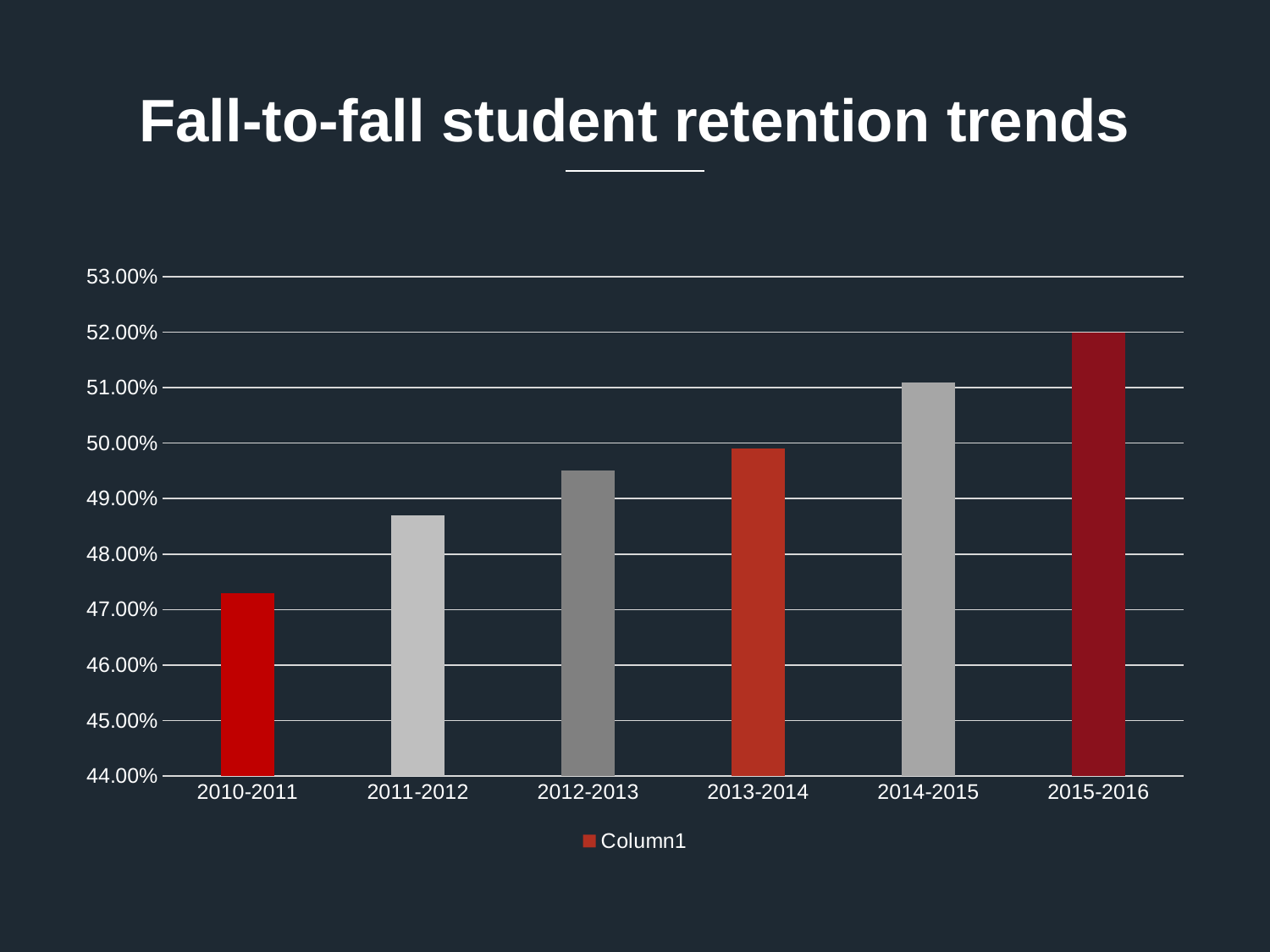
Which academic year has the highest retention rate? 2015-2016 What is the name of the series shown in the legend? Column1 How many academic years are shown on the x axis? 6 Do the retention rates rise or fall from 2010-2011 to 2015-2016? rise What kind of chart is shown on the slide? bar chart Is the value for 2011-2012 greater or less than 48.00%? greater Which is larger, the value for 2014-2015 or the value for 2012-2013? 2014-2015 How many series does the legend list? 1 Is the value for 2012-2013 greater or less than 50.00%? less Is the value for 2010-2011 greater or less than 48.00%? less What is the title of the chart? Fall-to-fall student retention trends Which academic year has the lowest retention rate? 2010-2011